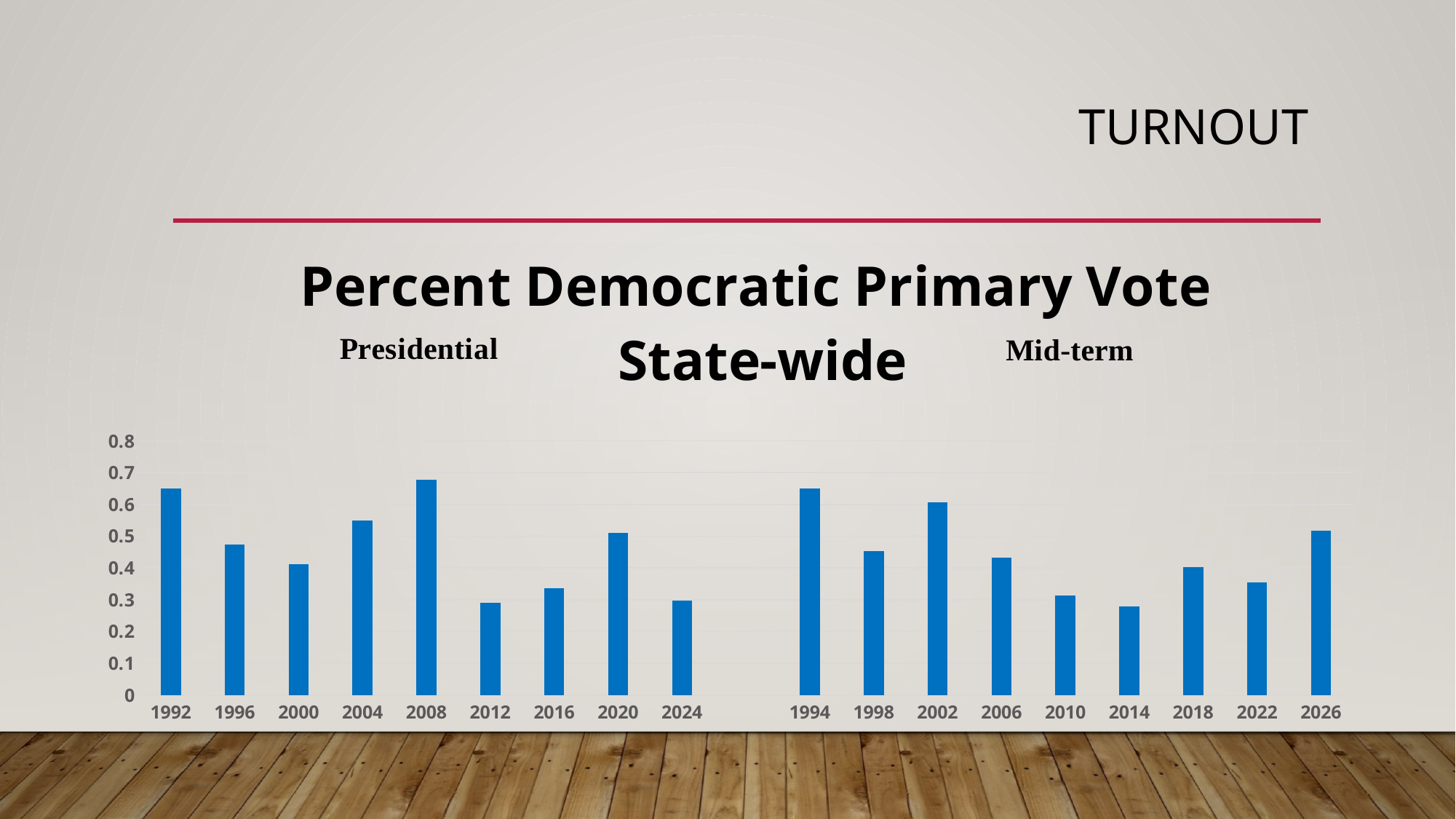
What is the title of the chart? Percent Democratic Primary Vote State-wide Is the value for 1992 greater or less than 0.6? greater Which has the larger value, 2008 or 2012? 2008 How many years (bars) are plotted in the chart? 18 Is the value for 2014 greater or less than 0.4? less Do the values rise or fall from 2008 to 2012? fall What kind of chart is shown on the slide? bar chart Is the value for 2002 greater or less than 0.5? greater What are the two group labels shown above the bars? Presidential and Mid-term Which has the larger value, 1994 or 1998? 1994